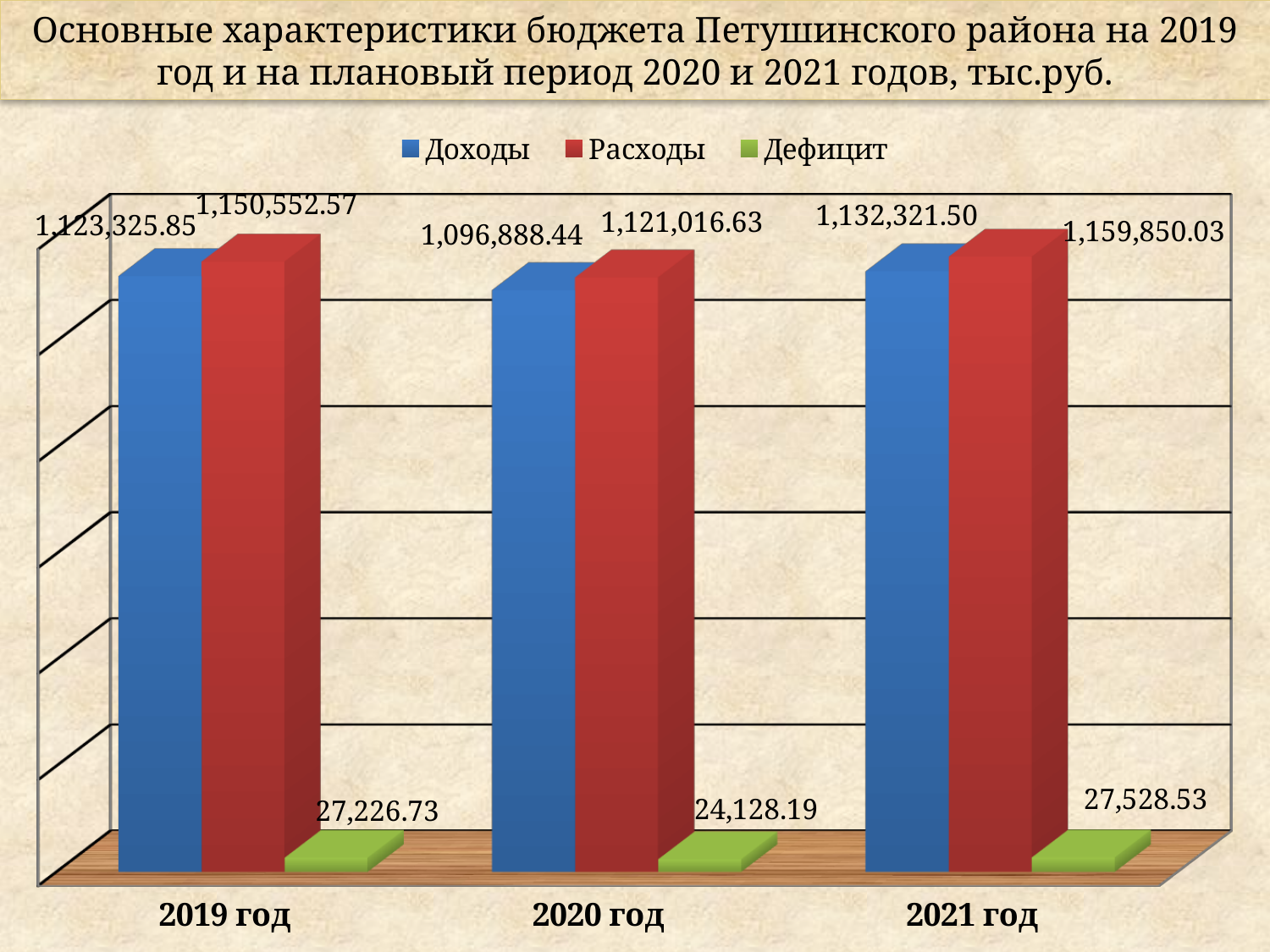
What is the difference between Расходы and Доходы for 2020 год? 24,128.19 What is the value of Доходы for 2019 год? 1,123,325.85 Which year has the highest Доходы? 2021 год Which year has the lowest Расходы? 2020 год What is the value of Дефицит for 2020 год? 24,128.19 How many years are shown on the x axis? 3 What kind of chart is shown on the slide? Bar chart Which is larger for 2019 год, Доходы or Расходы? Расходы What is the value of Расходы for 2021 год? 1,159,850.03 Which year has the lowest Дефицит? 2020 год How many series does the legend list? 3 What is the value of Расходы for 2020 год? 1,121,016.63